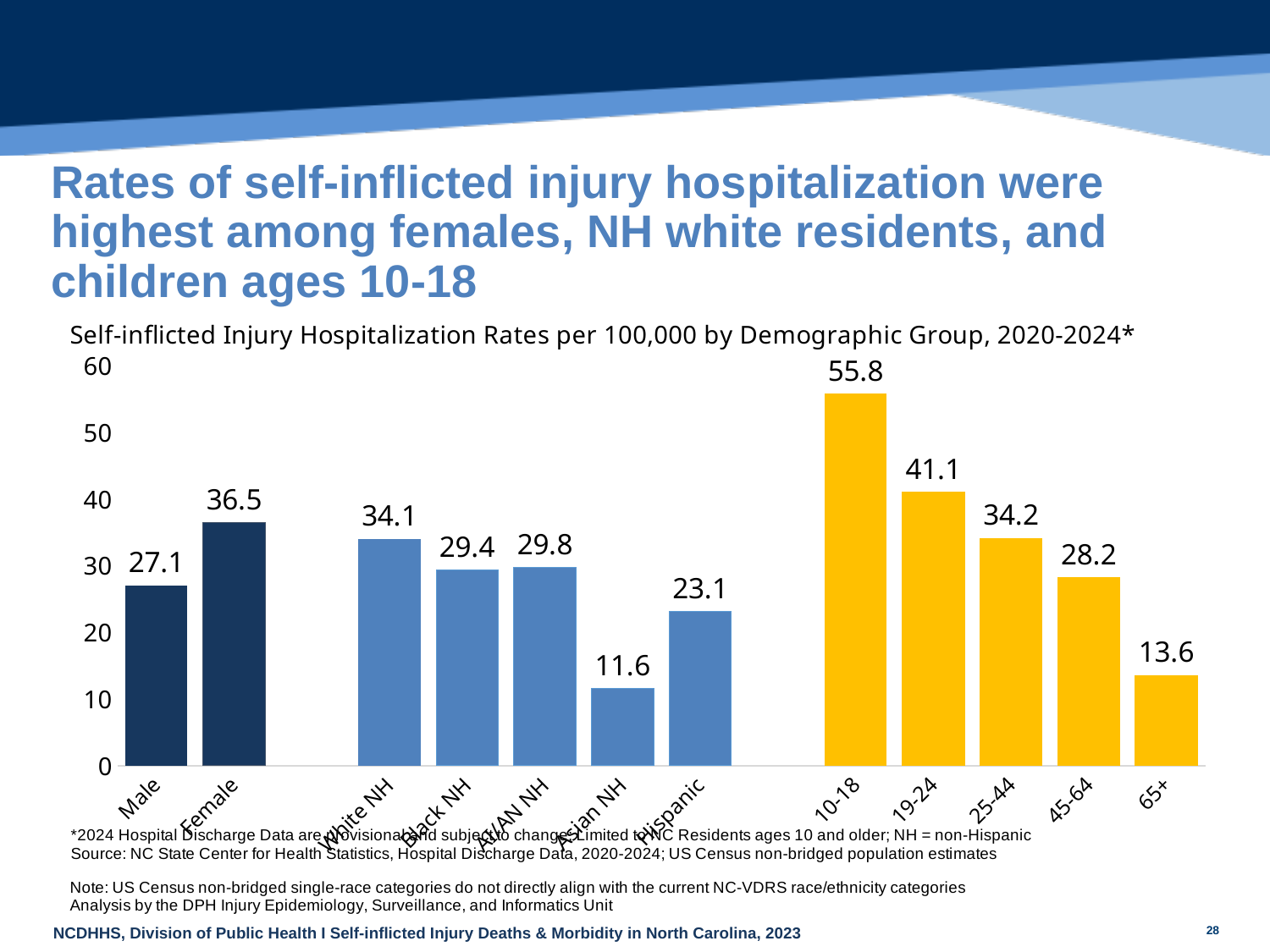
What is the hospitalization rate for the 10-18 age group? 55.8 Which demographic group has the highest hospitalization rate on the chart? 10-18 What is the hospitalization rate for Asian NH residents? 11.6 What is the hospitalization rate for the 65+ age group? 13.6 Which has a higher hospitalization rate, White NH or Hispanic residents? White NH What is the self-inflicted injury hospitalization rate per 100,000 for females? 36.5 What is the difference between the hospitalization rates for the 10-18 and 19-24 age groups? 14.7 How many demographic groups are shown on the chart? 12 Which demographic group has the lowest hospitalization rate on the chart? Asian NH What type of chart is shown on the slide? Bar chart What is the difference between the female and male hospitalization rates? 9.4 Do the hospitalization rates rise or fall across the age groups from 10-18 to 65+? Fall